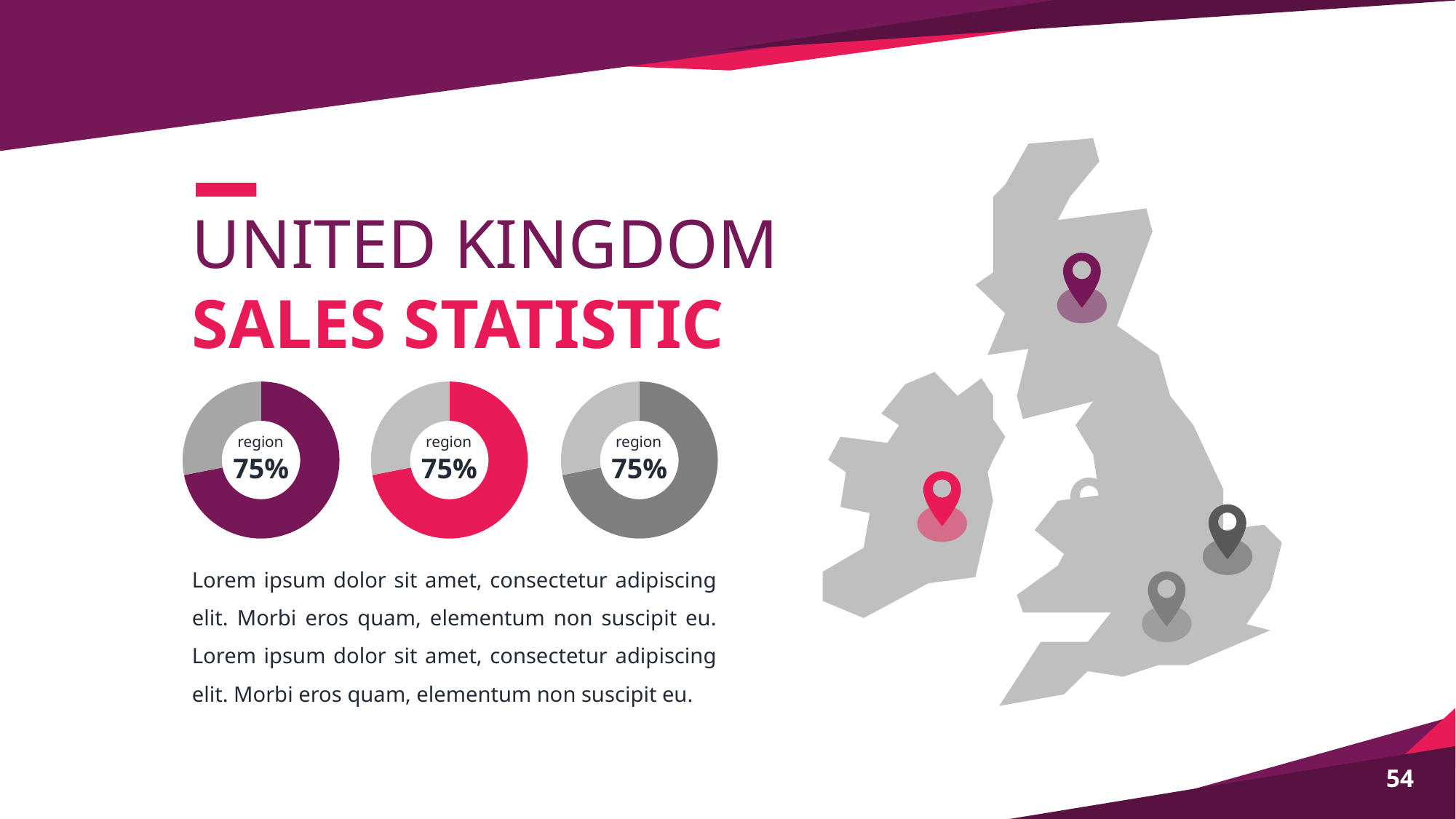
How many donut charts are shown on the slide? 3 Is the value shown in the left donut chart larger than, smaller than, or equal to the value in the middle donut chart? equal What value is shown in the centre of the middle (pink) donut chart? 75% What label appears above the percentage in each donut chart? region What value is shown in the centre of the right (grey) donut chart? 75% What kind of chart is used to show the three "region" values on the slide? donut chart What is the difference between the value in the middle donut chart and the value in the right donut chart? 0% Is the value in the right donut chart greater or less than 50%? greater What value is shown in the centre of the left (purple) donut chart? 75% What colour is the filled portion of the middle donut chart? pink